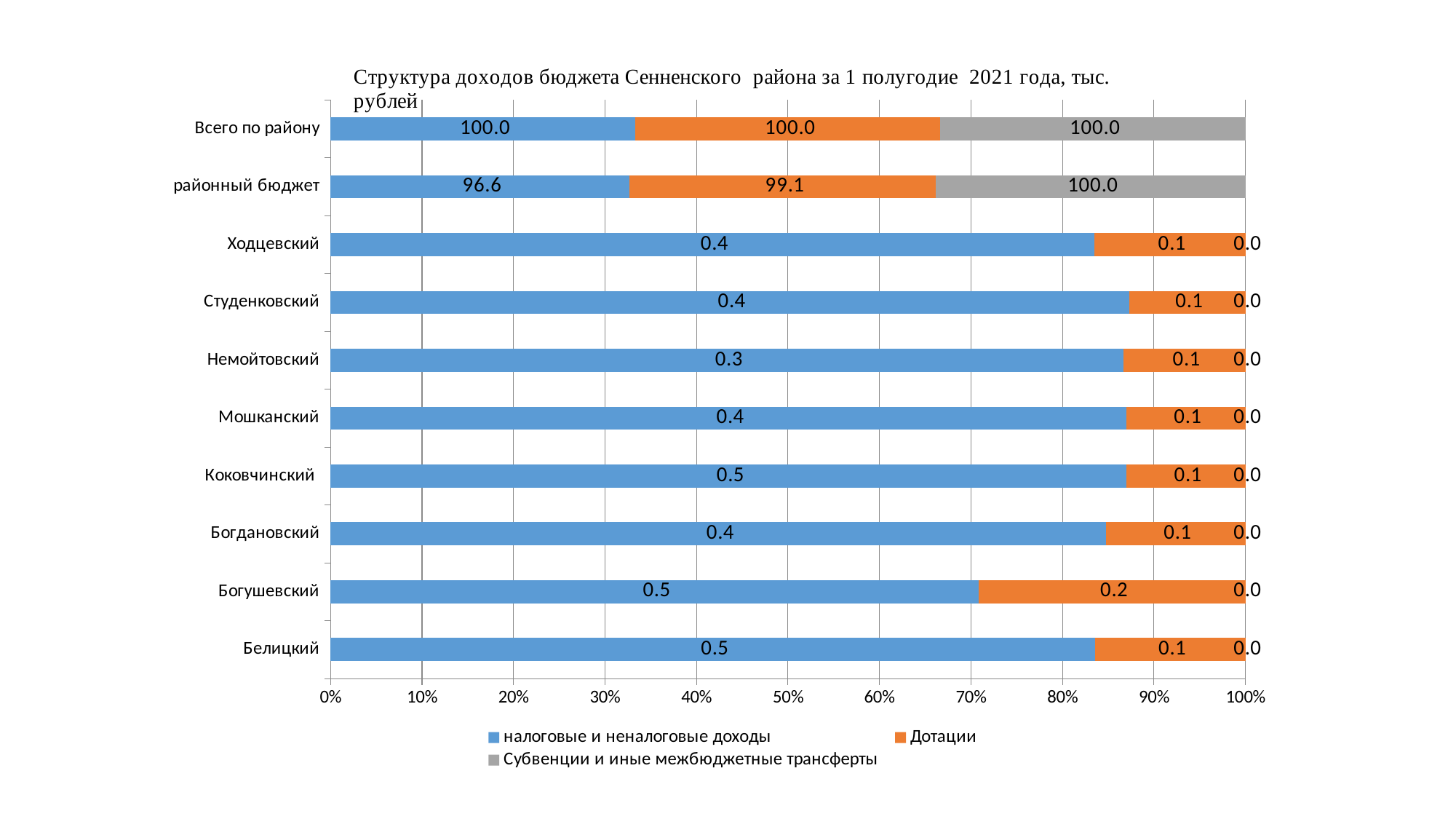
How many series does the legend list? 3 What is the value of налоговые и неналоговые доходы for районный бюджет? 96.6 Which category has the lowest labelled value for налоговые и неналоговые доходы? Немойтовский Which is larger, the Дотации value for Богушевский or for Белицкий? Богушевский What is the value of Дотации for районный бюджет? 99.1 What is the value of Субвенции и иные межбюджетные трансферты for Всего по району? 100.0 What is the difference between the налоговые и неналоговые доходы values for Всего по району and районный бюджет? 3.4 How many categories are shown on the vertical axis? 10 Is the share of the bar taken by налоговые и неналоговые доходы for Богушевский greater or less than 80%? less What kind of chart is shown on the slide? stacked bar chart What is the value of Дотации for Богушевский? 0.2 Which series is shown in grey in the legend? Субвенции и иные межбюджетные трансферты